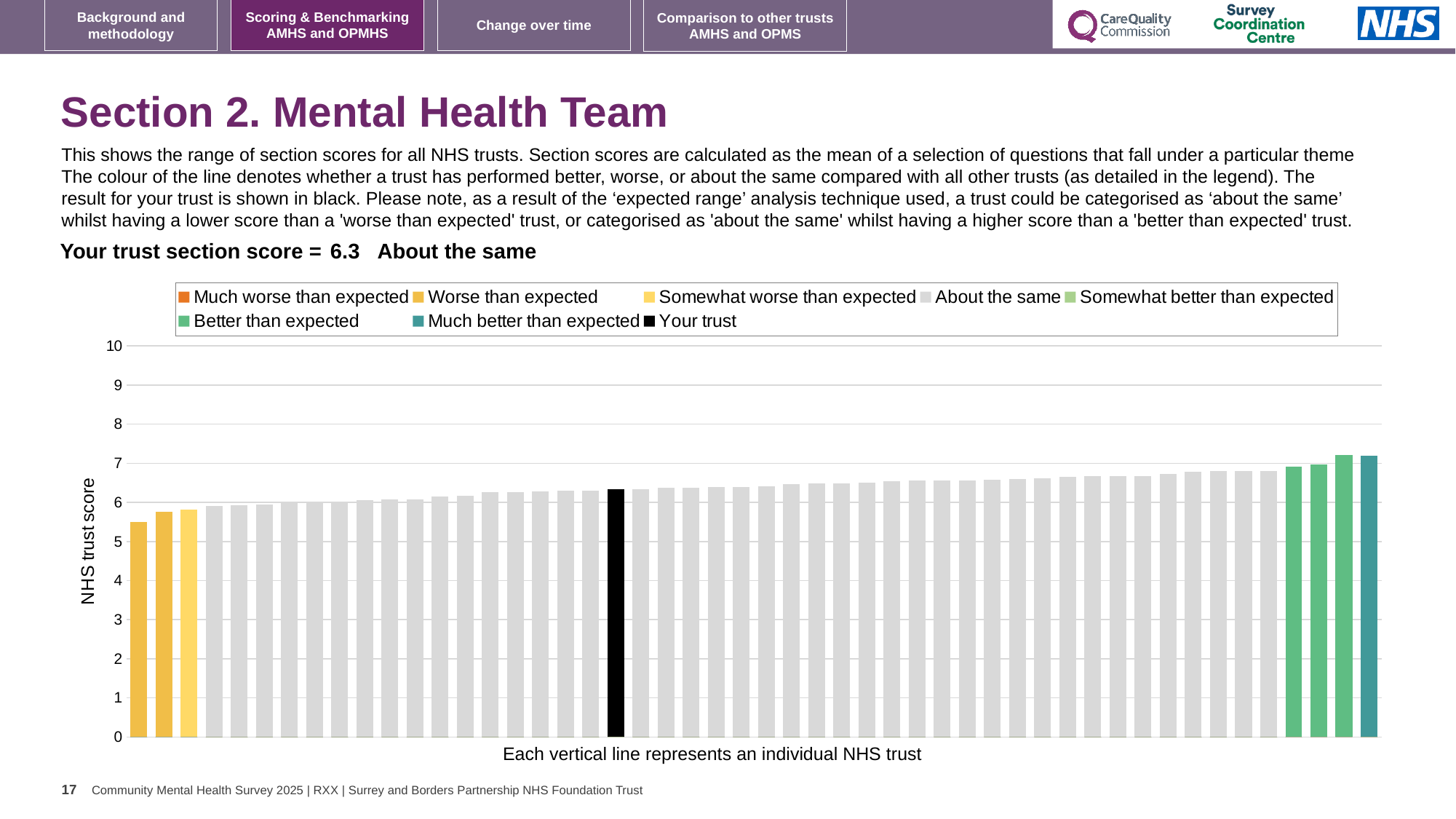
Do the bar values rise or fall from left to right along the x axis? rise Is the value for your trust greater or less than 5? greater What is the label on the vertical axis of the chart? NHS trust score Which category is your trust placed in for this section? About the same What is the section score for your trust shown on the slide? 6.3 Which is higher, the bar for your trust or the leftmost bar? Your trust Is the value of the tallest bar greater or less than 8? less Is the value for your trust greater or less than 7? less What colour is used for the bar representing your trust? black How many entries does the chart legend list? 8 What kind of chart is shown on the slide? bar chart